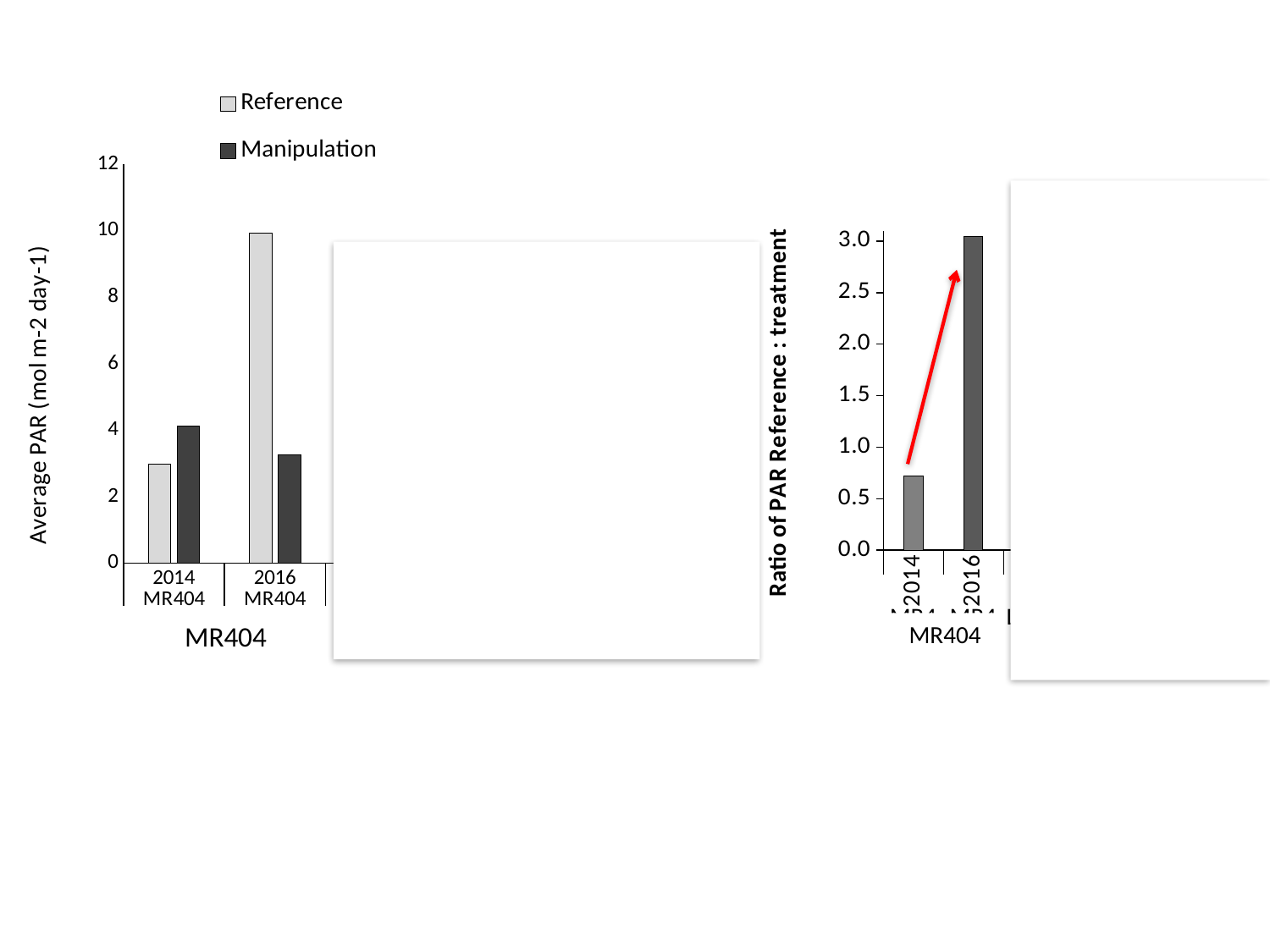
In the left chart (Average PAR), is the Reference value for 2014 MR404 greater or less than 4? less In the right chart (Ratio of PAR Reference : treatment), is the value for 2014 greater or less than 1.0? less In the left chart (Average PAR), which series has the larger value for 2014 MR404, Reference or Manipulation? Manipulation In the left chart (Average PAR), which bar is the highest? Reference, 2016 MR404 In the right chart (Ratio of PAR Reference : treatment), is the value for 2016 greater or less than 2.5? greater In the right chart (Ratio of PAR Reference : treatment), does the value rise or fall from 2014 to 2016? rise How many series does the legend of the left chart (Average PAR) list? 2 In the left chart (Average PAR), which series has the larger value for 2016 MR404, Reference or Manipulation? Reference What are the two series named in the legend of the left chart (Average PAR)? Reference and Manipulation What kind of chart is the left chart (Average PAR)? bar chart